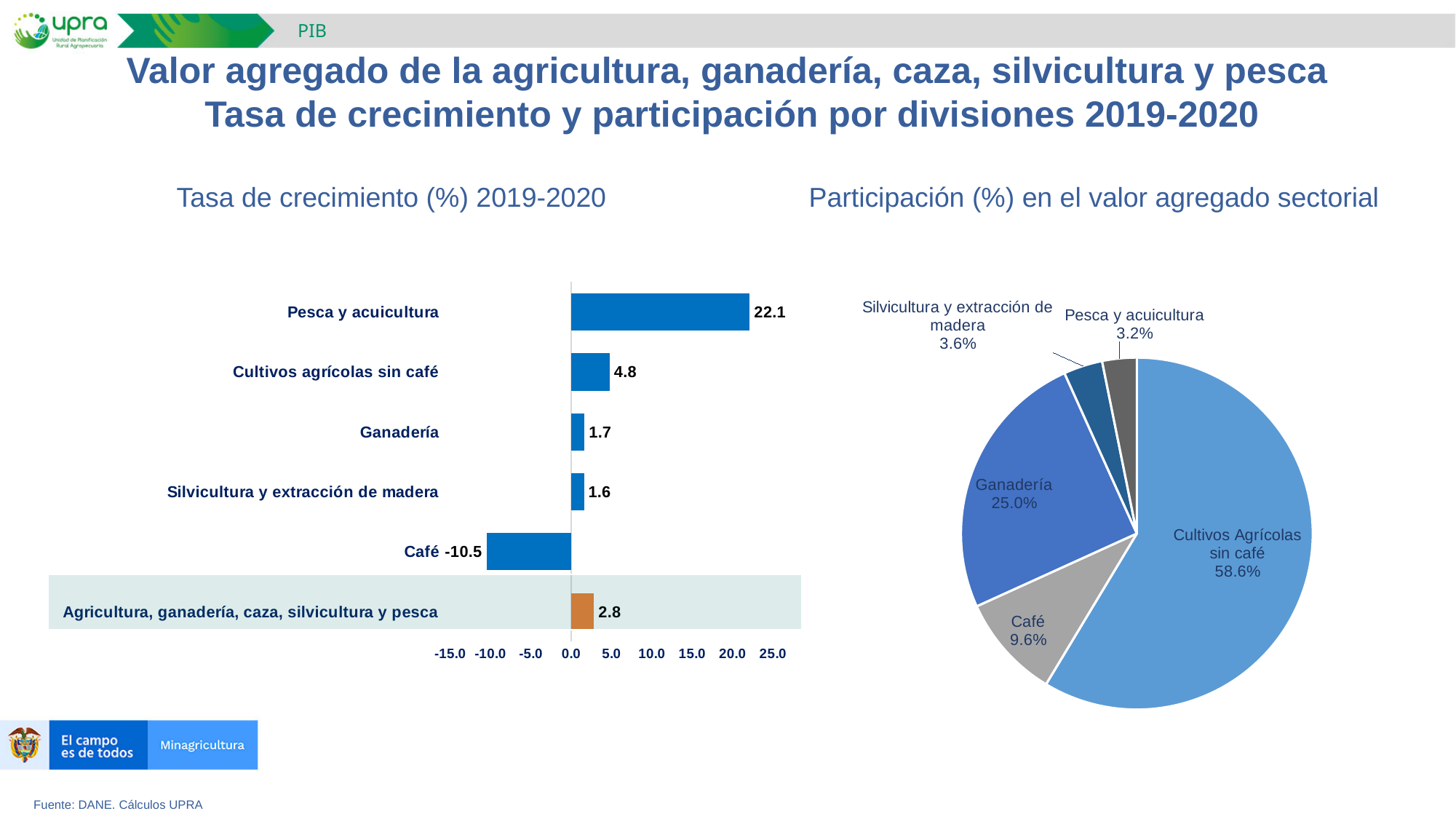
In the 'Tasa de crecimiento (%) 2019-2020' chart, what is the value for Café? -10.5 How many slices does the 'Participación (%) en el valor agregado sectorial' pie chart have? 5 In the 'Participación (%) en el valor agregado sectorial' pie chart, which slice is the largest? Cultivos Agrícolas sin café In the 'Tasa de crecimiento (%) 2019-2020' chart, what is the value for Pesca y acuicultura? 22.1 In the 'Tasa de crecimiento (%) 2019-2020' chart, which category has the lowest value? Café In the 'Tasa de crecimiento (%) 2019-2020' chart, what is the value for Agricultura, ganadería, caza, silvicultura y pesca? 2.8 What kind of chart is the 'Tasa de crecimiento (%) 2019-2020' chart? Bar chart In the 'Participación (%) en el valor agregado sectorial' pie chart, what share does Ganadería have? 25.0% In the 'Tasa de crecimiento (%) 2019-2020' chart, which category has the highest value? Pesca y acuicultura In the 'Tasa de crecimiento (%) 2019-2020' chart, what is the difference between the values for Pesca y acuicultura and Cultivos agrícolas sin café? 17.3 In the 'Tasa de crecimiento (%) 2019-2020' chart, which is larger: the value for Ganadería or the value for Silvicultura y extracción de madera? Ganadería How many categories are shown in the 'Tasa de crecimiento (%) 2019-2020' chart? 6